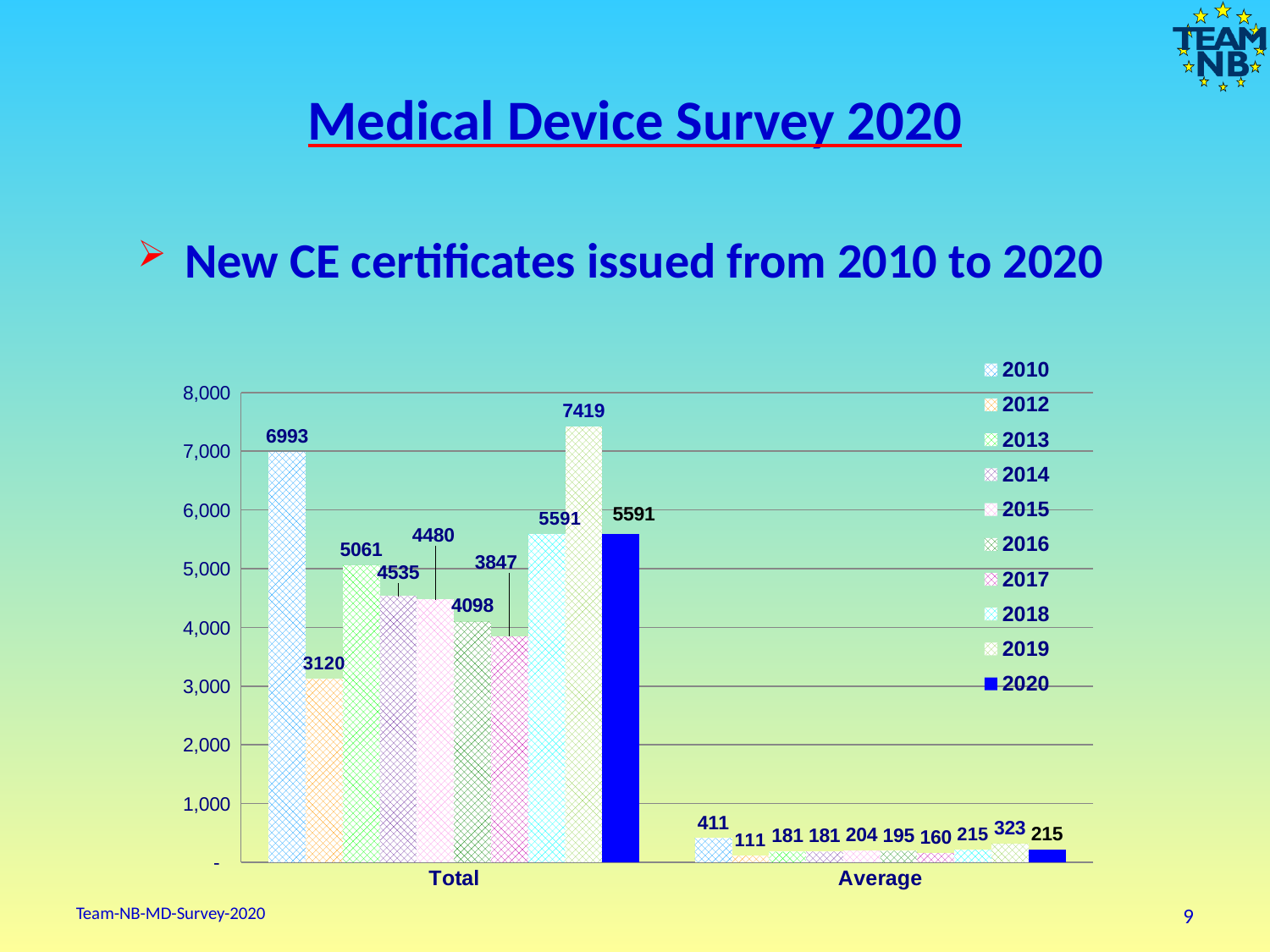
Which is larger, the Total value for 2013 or for 2014? 2013 What kind of chart is shown on the slide? Bar chart What is the Total value for 2012? 3120 What is the difference between the Total values for 2019 and 2010? 426 Which year has the highest Total value? 2019 What is the Average value for 2019? 323 Which year is shown as a solid blue bar in the legend? 2020 How many series does the legend list? 10 Which year has the lowest Average value? 2012 Which year has the lowest Total value? 2012 What is the Total value for 2019? 7419 What is the Average value for 2010? 411